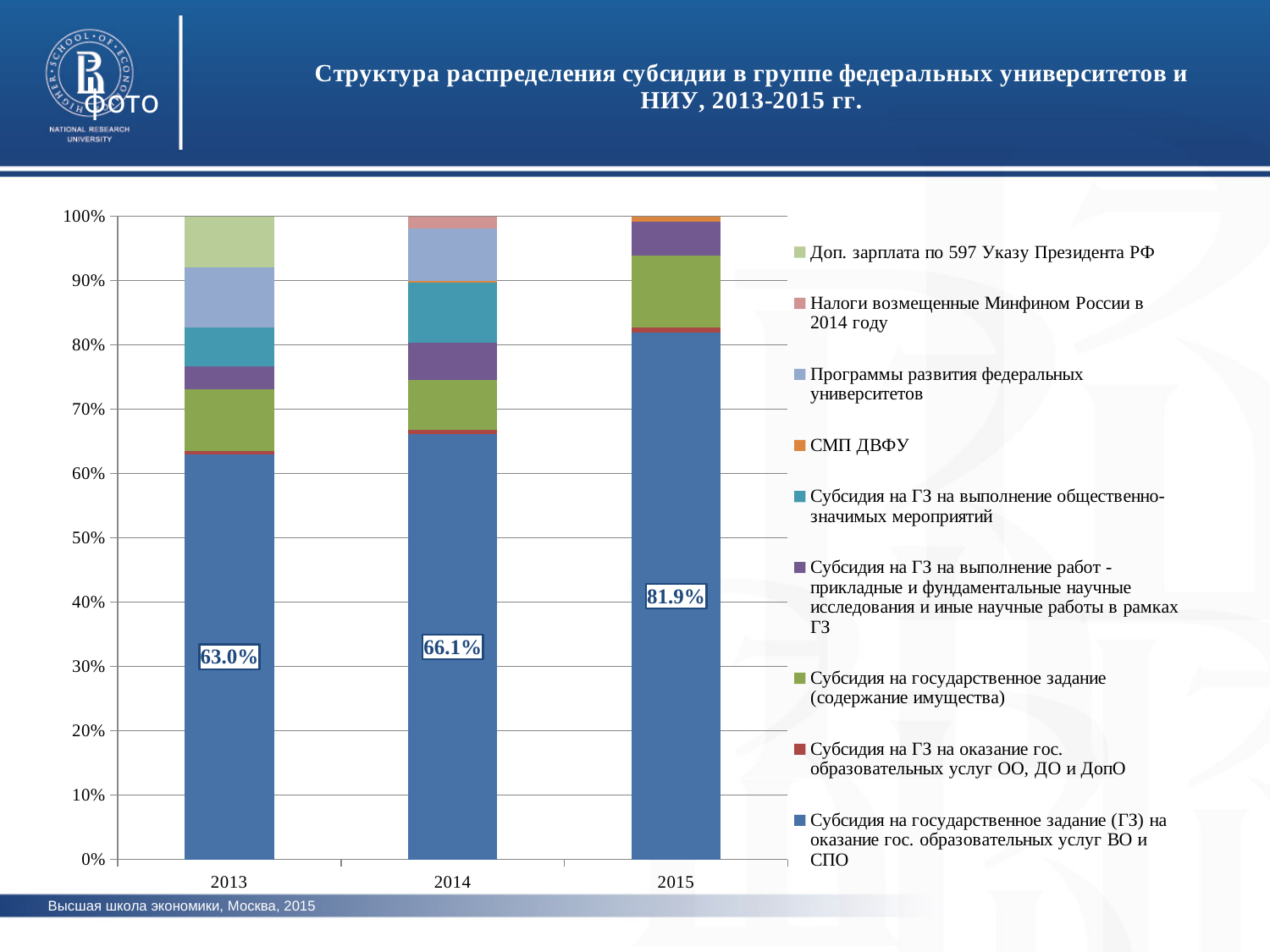
How many years (categories) are shown on the x axis of the chart? 3 Does the labelled share of the bottom series rise or fall from 2013 to 2015? rise What is the labelled share of 'Субсидия на государственное задание (ГЗ) на оказание гос. образовательных услуг ВО и СПО' in 2013? 63.0% By how many percentage points did the labelled share of the bottom series change from 2013 to 2015? 18.9 percentage points What is the labelled share of 'Субсидия на государственное задание (ГЗ) на оказание гос. образовательных услуг ВО и СПО' in 2014? 66.1% What kind of chart is shown on the slide? stacked bar chart Which year has the larger labelled share for the bottom series, 2013 or 2014? 2014 How many series does the chart legend list? 9 What is the labelled share of 'Субсидия на государственное задание (ГЗ) на оказание гос. образовательных услуг ВО и СПО' in 2015? 81.9% In which year is the labelled share of the bottom series (ГЗ на оказание гос. образовательных услуг ВО и СПО) highest? 2015 Which series appears only in the 2013 bar, at the top, in light green? Доп. зарплата по 597 Указу Президента РФ In which year is the labelled share of the bottom series (ГЗ на оказание гос. образовательных услуг ВО и СПО) lowest? 2013